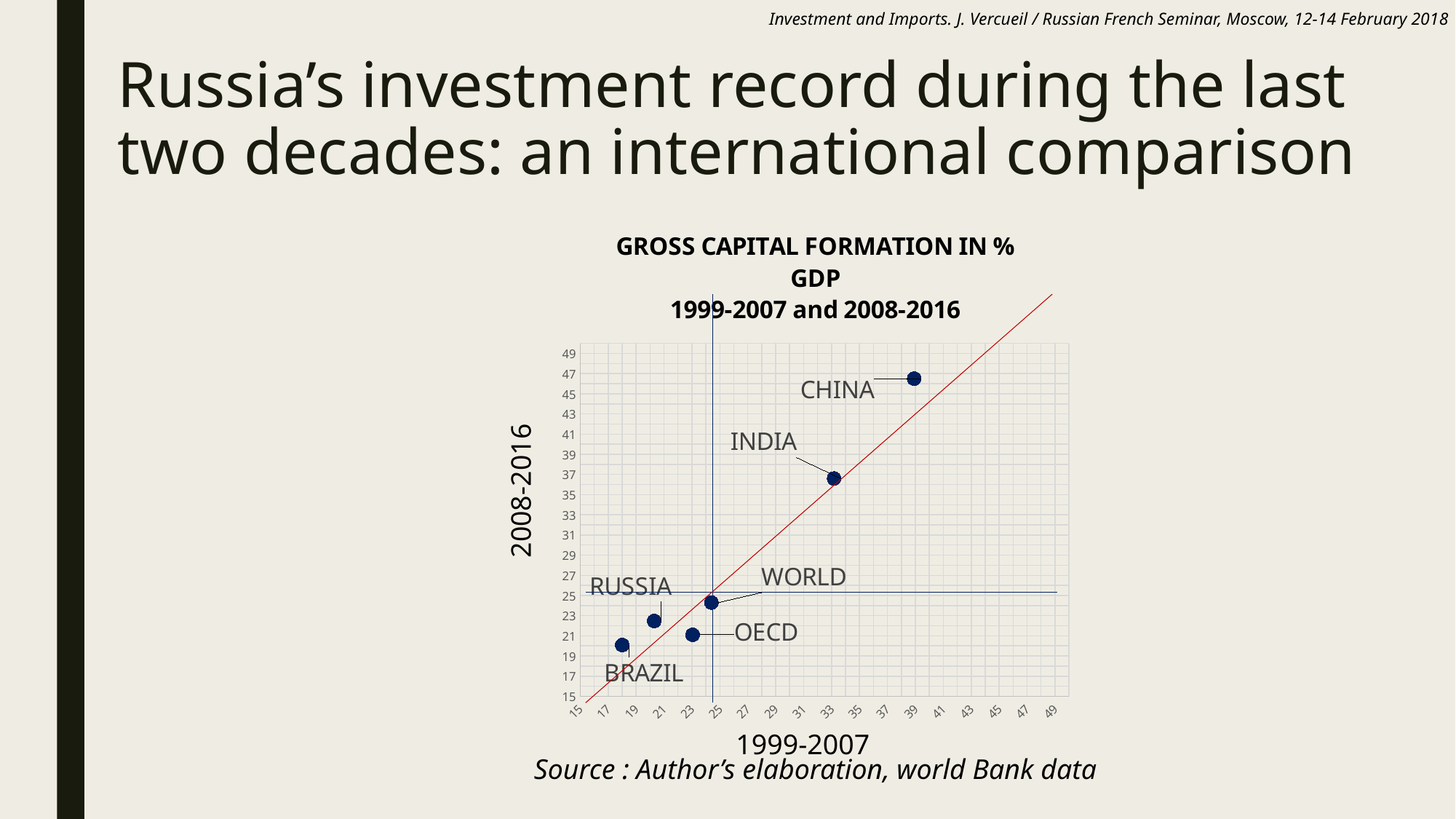
Is the 2008-2016 value for INDIA greater or less than 35? greater What is the title of the chart? GROSS CAPITAL FORMATION IN % GDP 1999-2007 and 2008-2016 Is the 1999-2007 value for OECD greater or less than 25? less Is the 2008-2016 value for RUSSIA greater or less than 25? less Which country or group has the lowest gross capital formation for 1999-2007? BRAZIL Which has a higher 1999-2007 value, RUSSIA or BRAZIL? RUSSIA What kind of chart is shown on the slide? Scatter chart How many labelled data points are plotted on the chart? 6 What is the label of the vertical axis of the chart? 2008-2016 Which has a higher 2008-2016 value, CHINA or INDIA? CHINA Which country or group has the highest gross capital formation for 2008-2016? CHINA